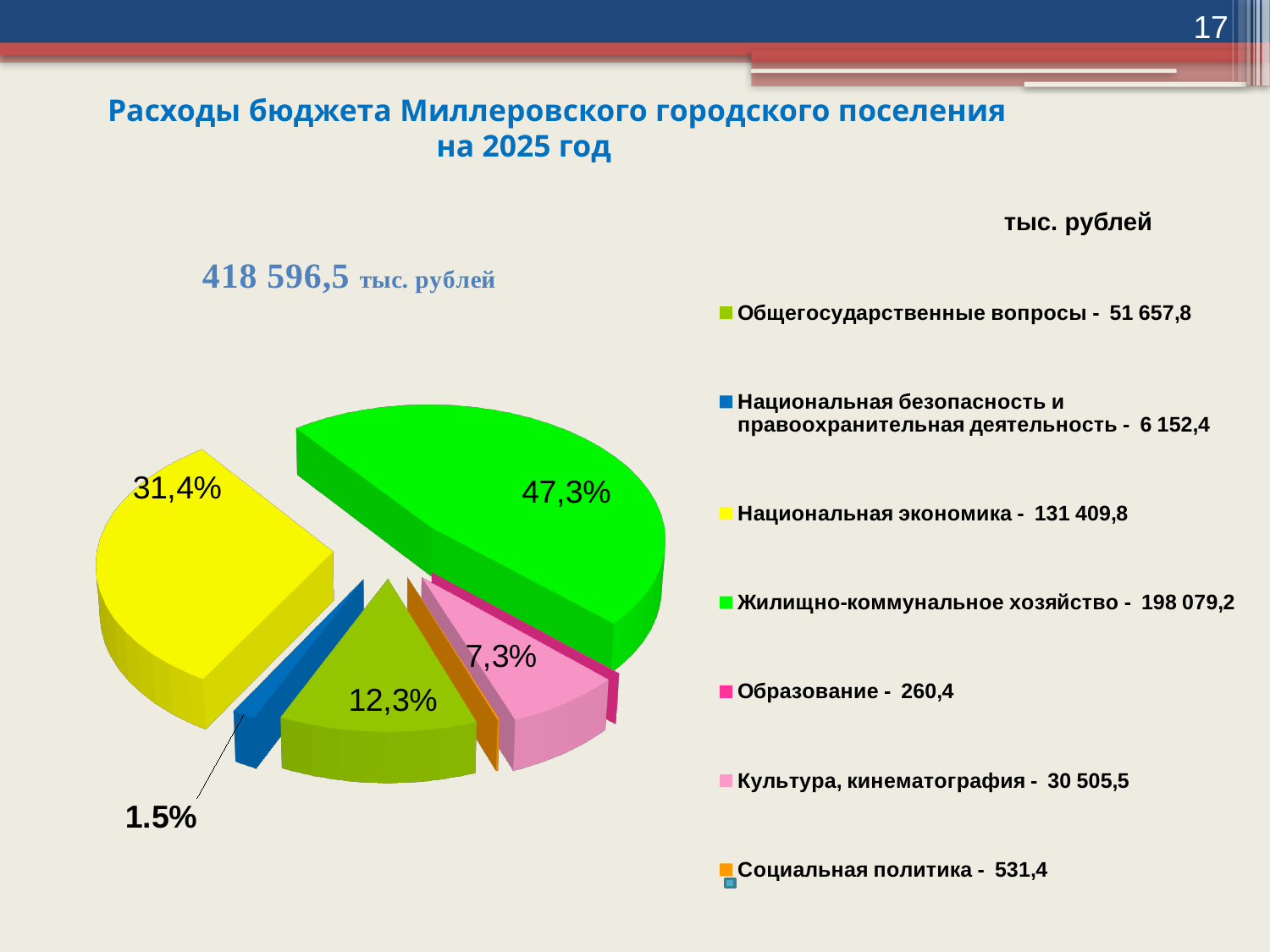
What percentage share is labelled on the yellow Национальная экономика slice? 31,4% What is the value for Жилищно-коммунальное хозяйство in the legend? 198 079,2 What kind of chart is shown on the slide? pie chart What percentage share is labelled on the green Жилищно-коммунальное хозяйство slice? 47,3% What is the value for Культура, кинематография in the legend? 30 505,5 How many categories does the legend of the pie chart list? 7 Which is larger, the value for Общегосударственные вопросы or the value for Культура, кинематография? Общегосударственные вопросы Which category has the largest share of the pie? Жилищно-коммунальное хозяйство What is the value for Национальная экономика in the legend? 131 409,8 What total amount in тыс. рублей is shown above the pie chart? 418 596,5 What is the value for Образование in the legend? 260,4 Which category has the smallest value in the legend? Образование